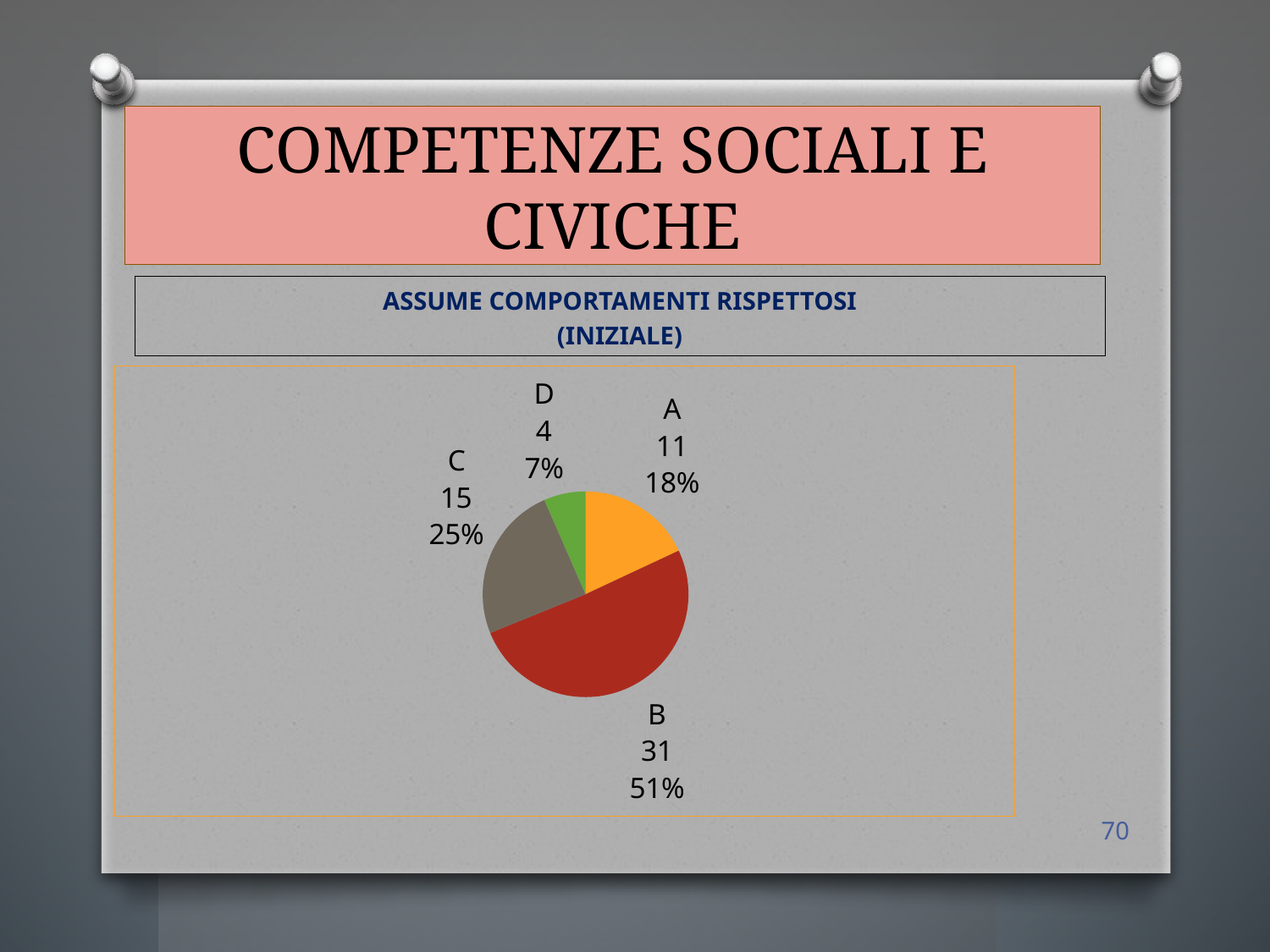
What is the value for category B? 31 Which category has the smallest slice? D What is the value for category D? 4 What is the value for category C? 15 How many categories does the pie chart have? 4 What percentage share does category B have? 51% What is the total of all the values in the pie chart? 61 What kind of chart is shown on the slide? pie chart What is the difference between the values for B and C? 16 Which is larger, the value for A or the value for C? C What percentage share does category A have? 18% Which category has the largest slice? B